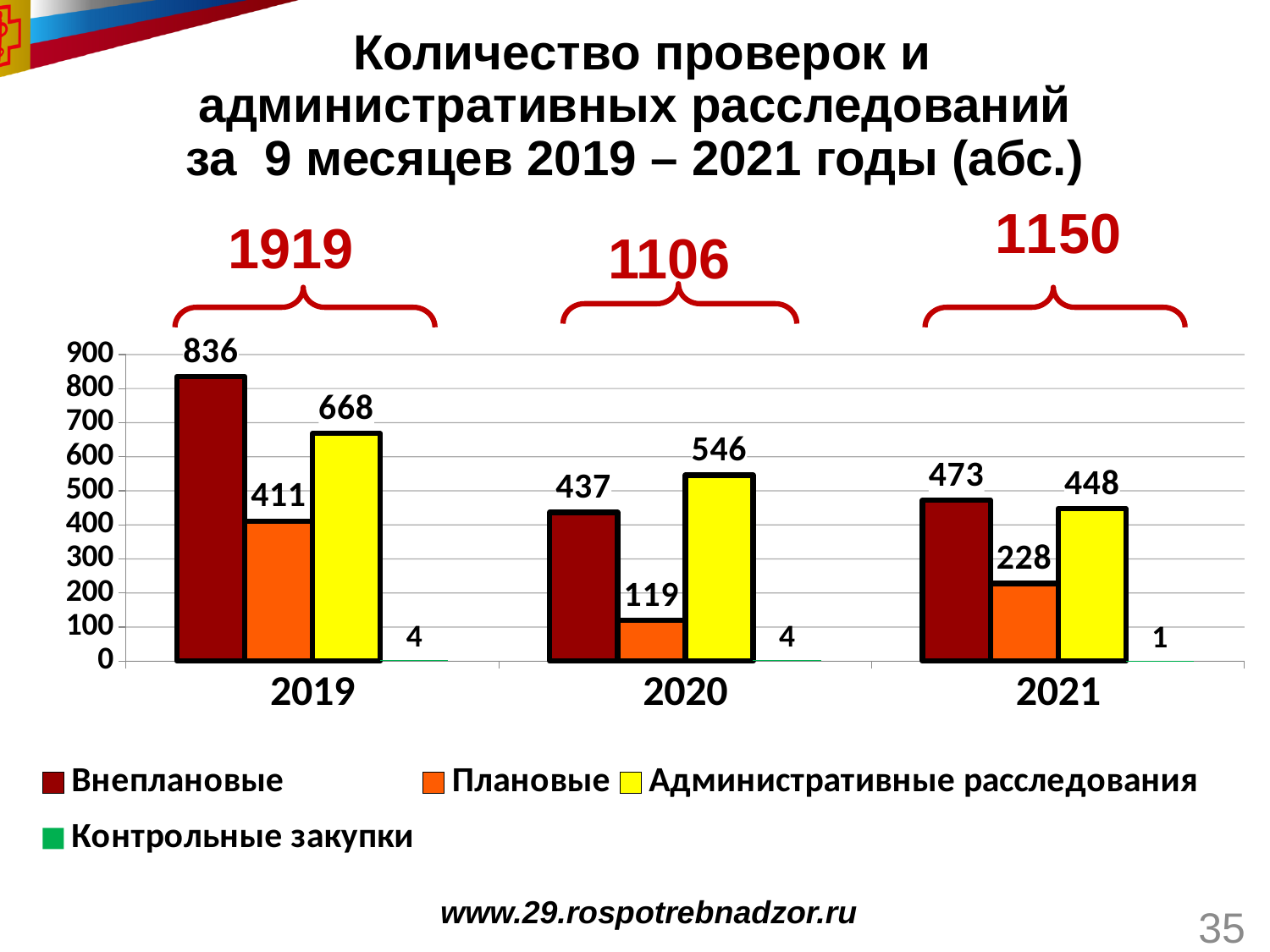
What is the value for Административные расследования in 2021? 448 How many years are shown on the x axis? 3 What is the value for Контрольные закупки in 2021? 1 What is the value for Внеплановые in 2019? 836 What is the value for Плановые in 2020? 119 Which is larger in 2021: Внеплановые or Административные расследования? Внеплановые In which year is the value for Плановые the lowest? 2020 How many series does the legend list? 4 What is the difference between the Внеплановые values for 2019 and 2020? 399 What total is shown above the group of bars for 2020? 1106 What kind of chart is shown on the slide? Bar chart In which year is the value for Внеплановые the highest? 2019